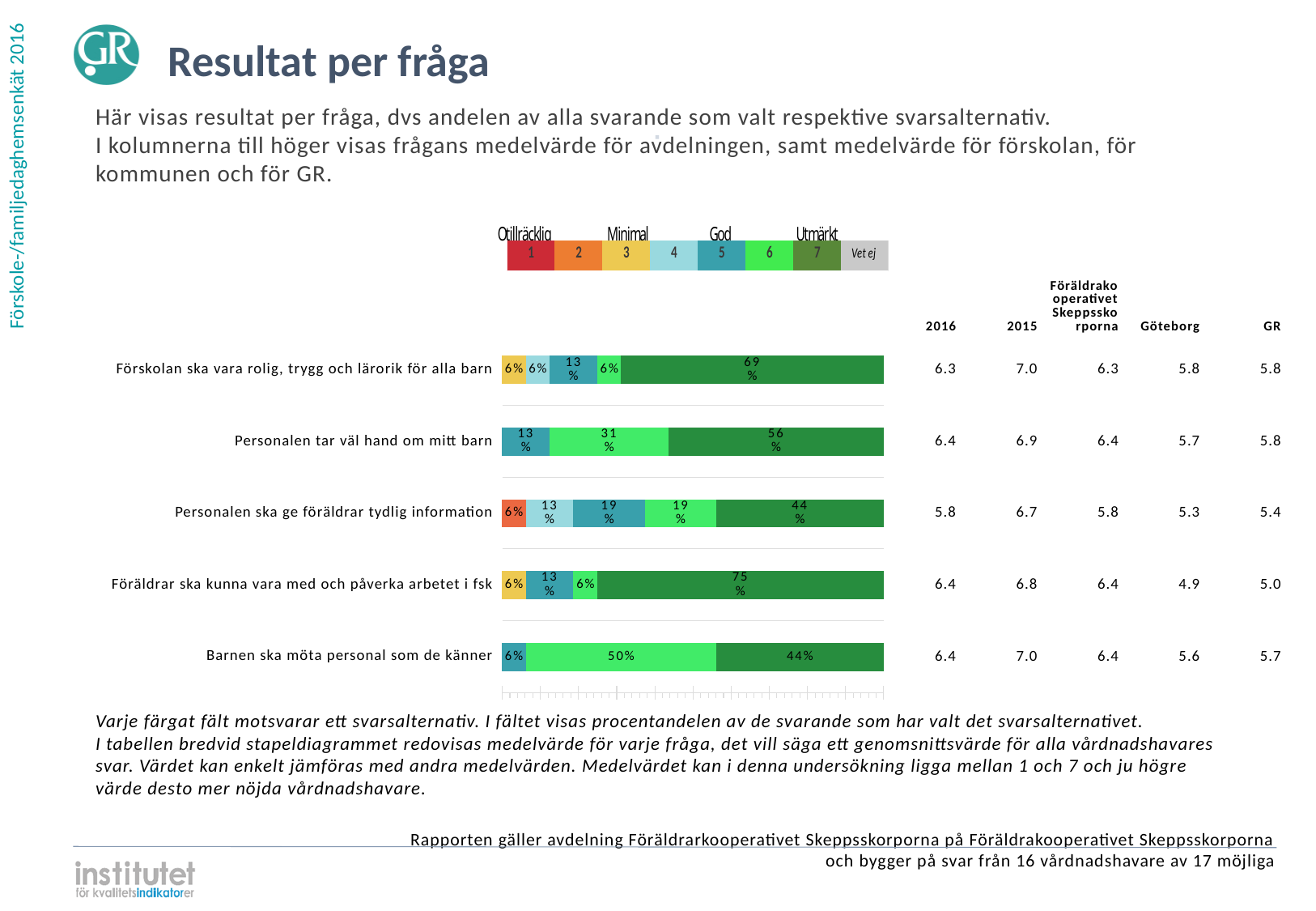
What type of chart is shown on the slide? Stacked bar chart What percentage of respondents chose answer 6 (light green) for 'Barnen ska möta personal som de känner'? 50% What is the difference between the answer-7 share for 'Föräldrar ska kunna vara med och påverka arbetet i fsk' and for 'Barnen ska möta personal som de känner'? 31% Which question has the smallest share of respondents choosing answer 7 (dark green)? Personalen ska ge föräldrar tydlig information and Barnen ska möta personal som de känner (both 44%) What percentage of respondents chose answer 7 (dark green) for 'Förskolan ska vara rolig, trygg och lärorik för alla barn'? 69% How many questions (categories) are plotted in the bar chart? 5 Which is larger: the answer-7 share for 'Personalen tar väl hand om mitt barn' or for 'Förskolan ska vara rolig, trygg och lärorik för alla barn'? Förskolan ska vara rolig, trygg och lärorik för alla barn What percentage of respondents chose answer 7 (dark green) for 'Personalen ska ge föräldrar tydlig information'? 44% What percentage of respondents chose answer 6 (light green) for 'Personalen tar väl hand om mitt barn'? 31% What is the combined share of answers 6 and 7 for 'Barnen ska möta personal som de känner'? 94% Which question has the largest share of respondents choosing answer 7 (dark green)? Föräldrar ska kunna vara med och påverka arbetet i fsk How many answer categories does the legend above the chart show, including 'Vet ej'? 8